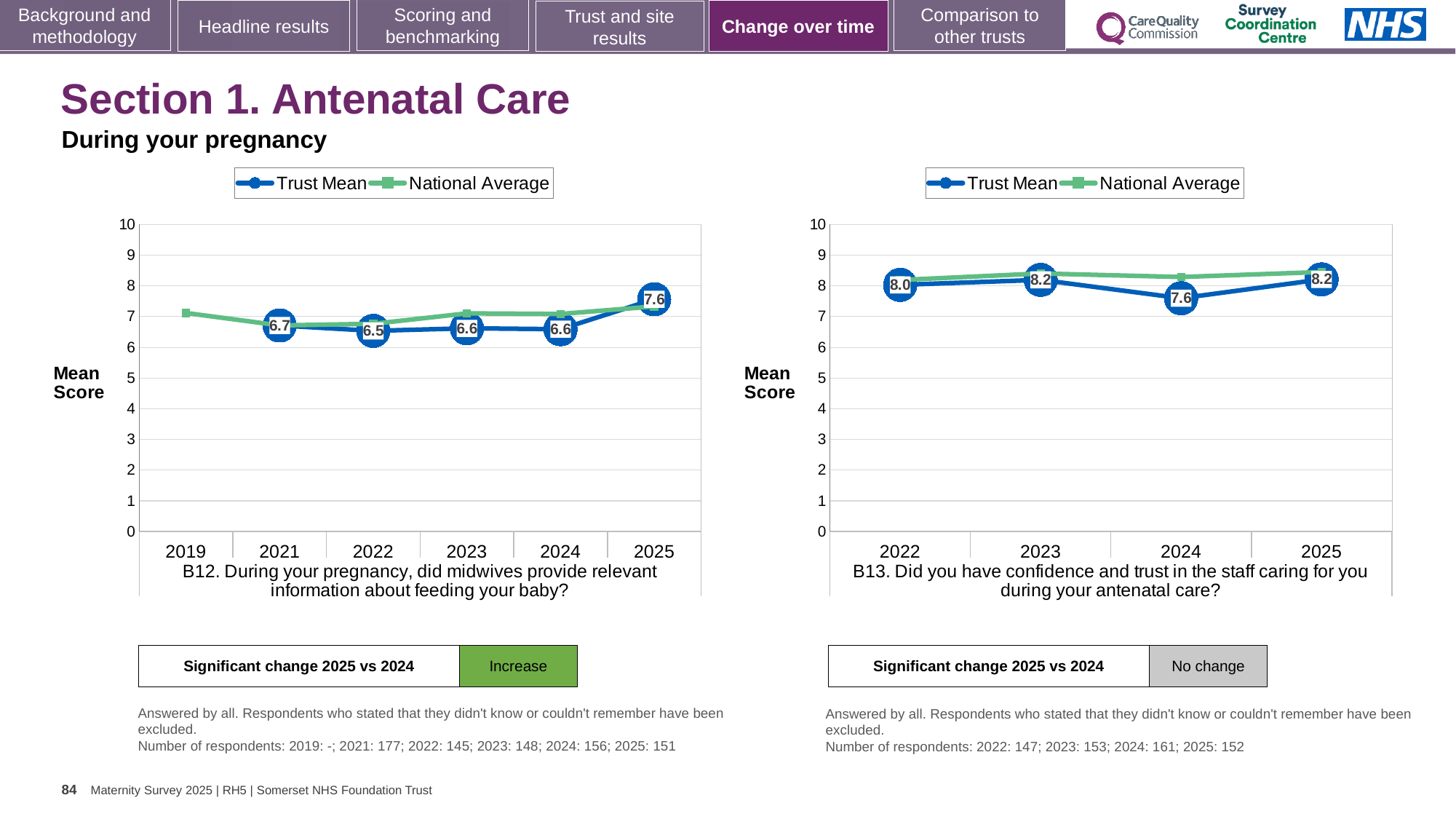
In the left chart (B12), what is the Trust Mean for 2025? 7.6 In the right chart (B13), what is the Trust Mean for 2024? 7.6 In the right chart (B13), what is the Trust Mean for 2022? 8.0 What kind of chart is the right chart (B13)? line chart How many years are shown on the x axis of the right chart (B13)? 4 In the right chart (B13), is the Trust Mean for 2023 larger or smaller than the Trust Mean for 2024? larger In the left chart (B12), what is the Trust Mean for 2022? 6.5 In the left chart (B12), is the National Average for 2019 greater or less than 6? greater In the left chart (B12), what is the difference between the Trust Mean for 2025 and the Trust Mean for 2024? 1.0 In the left chart (B12), which year has the highest Trust Mean? 2025 How many series does the legend of the left chart (B12) list? 2 In the right chart (B13), which year has the lowest Trust Mean? 2024